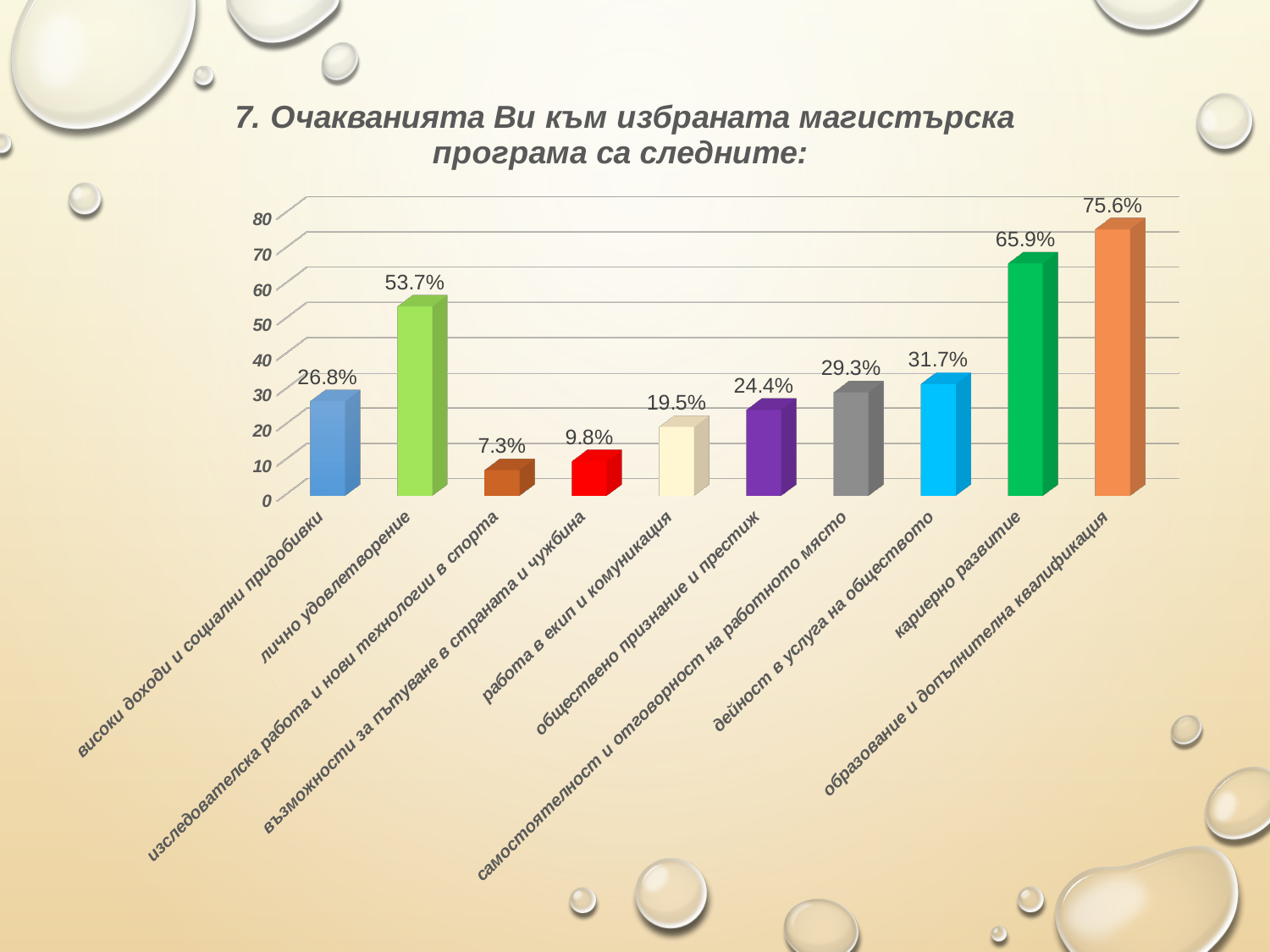
What is the title of the slide? 7. Очакванията Ви към избраната магистърска програма са следните: Which category has the highest value? образование и допълнителна квалификация What is the difference between the values for "образование и допълнителна квалификация" and "кариерно развитие"? 9.7% What kind of chart is shown on the slide? bar chart How many categories are shown in the chart? 10 What is the value for "работа в екип и комуникация"? 19.5% What is the value for "кариерно развитие"? 65.9% Is the value for "високи доходи и социални придобивки" greater or less than 30? less What is the difference between the values for "възможности за пътуване в страната и чужбина" and "изследователска работа и нови технологии в спорта"? 2.5% Which is larger, the value for "дейност в услуга на обществото" or the value for "самостоятелност и отговорност на работното място"? дейност в услуга на обществото Which category has the lowest value? изследователска работа и нови технологии в спорта What is the value for "лично удовлетворение"? 53.7%